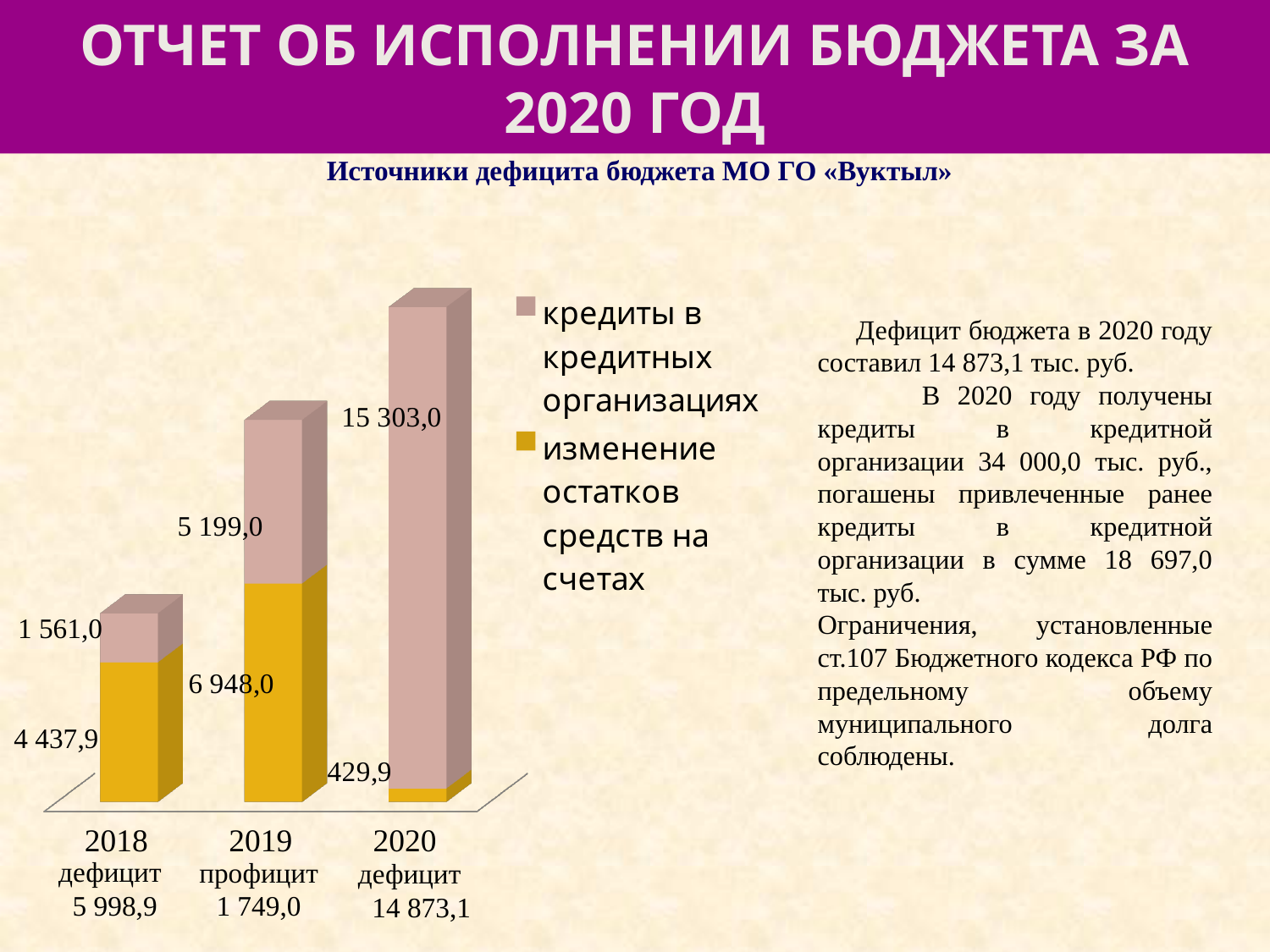
How many years (categories) are shown on the x axis? 3 What is the value of «изменение остатков средств на счетах» for 2018? 4 437,9 In which year is the value of «кредиты в кредитных организациях» the highest? 2020 In which year is the value of «изменение остатков средств на счетах» the lowest? 2020 What is the total of the stacked bar for 2019? 12 147,0 What is the value of «изменение остатков средств на счетах» for 2019? 6 948,0 What is the value of «кредиты в кредитных организациях» for 2018? 1 561,0 What is the value of «кредиты в кредитных организациях» for 2020? 15 303,0 What is the difference between the «кредиты в кредитных организациях» values for 2020 and 2019? 10 104,0 What kind of chart is shown on the slide? stacked bar chart How many series does the legend list? 2 Which is larger in 2019: «кредиты в кредитных организациях» or «изменение остатков средств на счетах»? изменение остатков средств на счетах